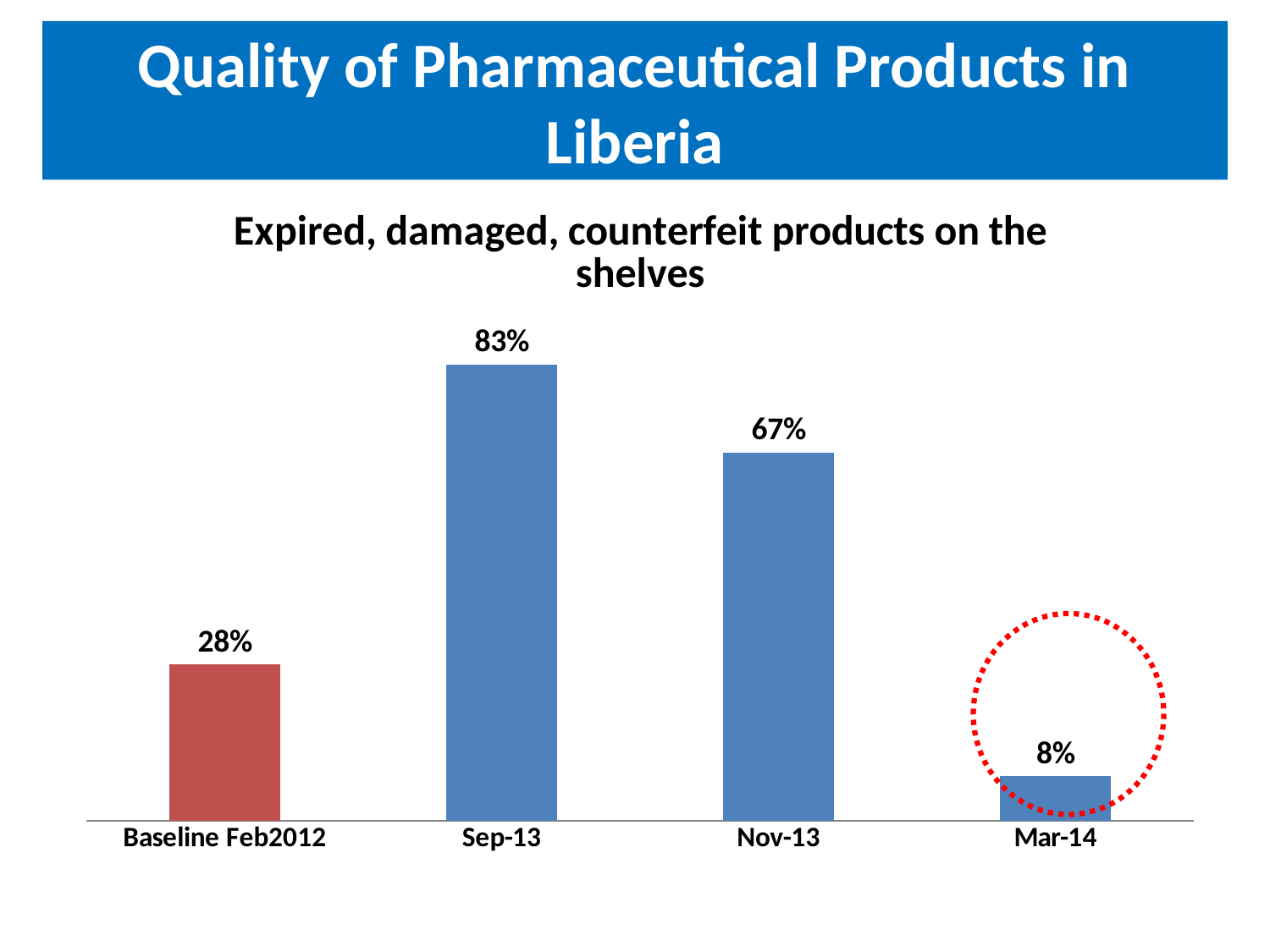
What is the value for Mar-14? 8% What is the value for Nov-13? 67% Which category has the highest value? Sep-13 What is the value for Baseline Feb2012? 28% What is the title of the chart? Expired, damaged, counterfeit products on the shelves Which category has the lowest value? Mar-14 What is the difference between the values for Sep-13 and Nov-13? 16% What kind of chart is this? Bar chart What is the difference between the values for Baseline Feb2012 and Mar-14? 20% Which is larger, the value for Nov-13 or the value for Baseline Feb2012? Nov-13 How many categories are shown on the x axis? 4 What is the value for Sep-13? 83%